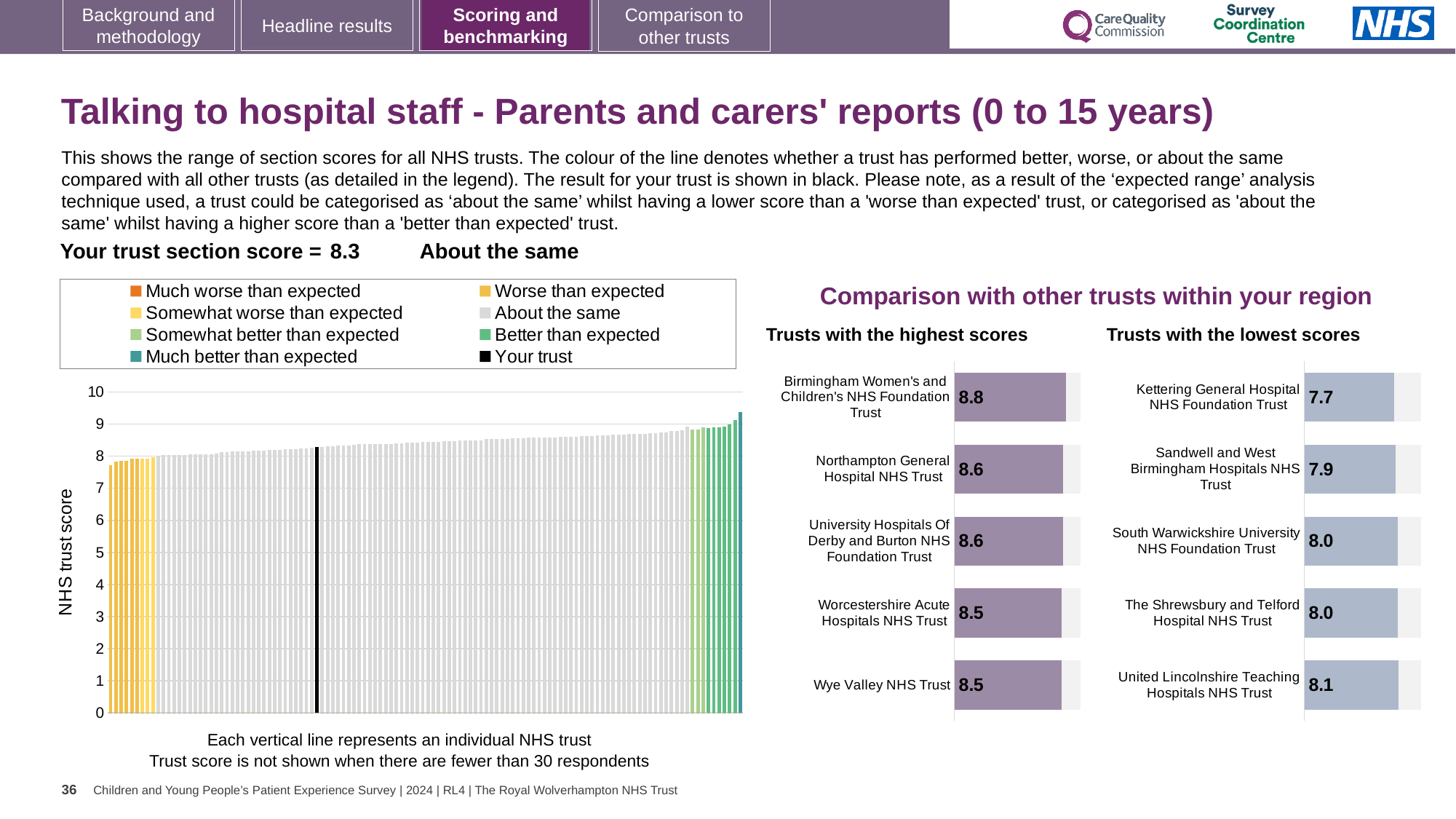
In the main NHS trust score chart, do the bar values rise or fall from left to right? Rise In the 'Trusts with the lowest scores' chart, which trust has the lowest score? Kettering General Hospital NHS Foundation Trust In the 'Trusts with the highest scores' chart, what is the score for Wye Valley NHS Trust? 8.5 How many trusts are listed in the 'Trusts with the highest scores' chart? 5 In the 'Trusts with the highest scores' chart, which trust has the highest score? Birmingham Women's and Children's NHS Foundation Trust In the 'Trusts with the lowest scores' chart, which has the larger score: Sandwell and West Birmingham Hospitals NHS Trust or United Lincolnshire Teaching Hospitals NHS Trust? United Lincolnshire Teaching Hospitals NHS Trust What is the difference between the score for Birmingham Women's and Children's NHS Foundation Trust in the highest scores chart and the score for Kettering General Hospital NHS Foundation Trust in the lowest scores chart? 1.1 In the 'Trusts with the lowest scores' chart, what is the score for Kettering General Hospital NHS Foundation Trust? 7.7 How many entries does the legend of the main NHS trust score chart list? 8 In the 'Trusts with the lowest scores' chart, what is the score for United Lincolnshire Teaching Hospitals NHS Trust? 8.1 In the 'Trusts with the highest scores' chart, what is the score for Birmingham Women's and Children's NHS Foundation Trust? 8.8 What kind of chart is the main chart showing the NHS trust scores? Bar chart